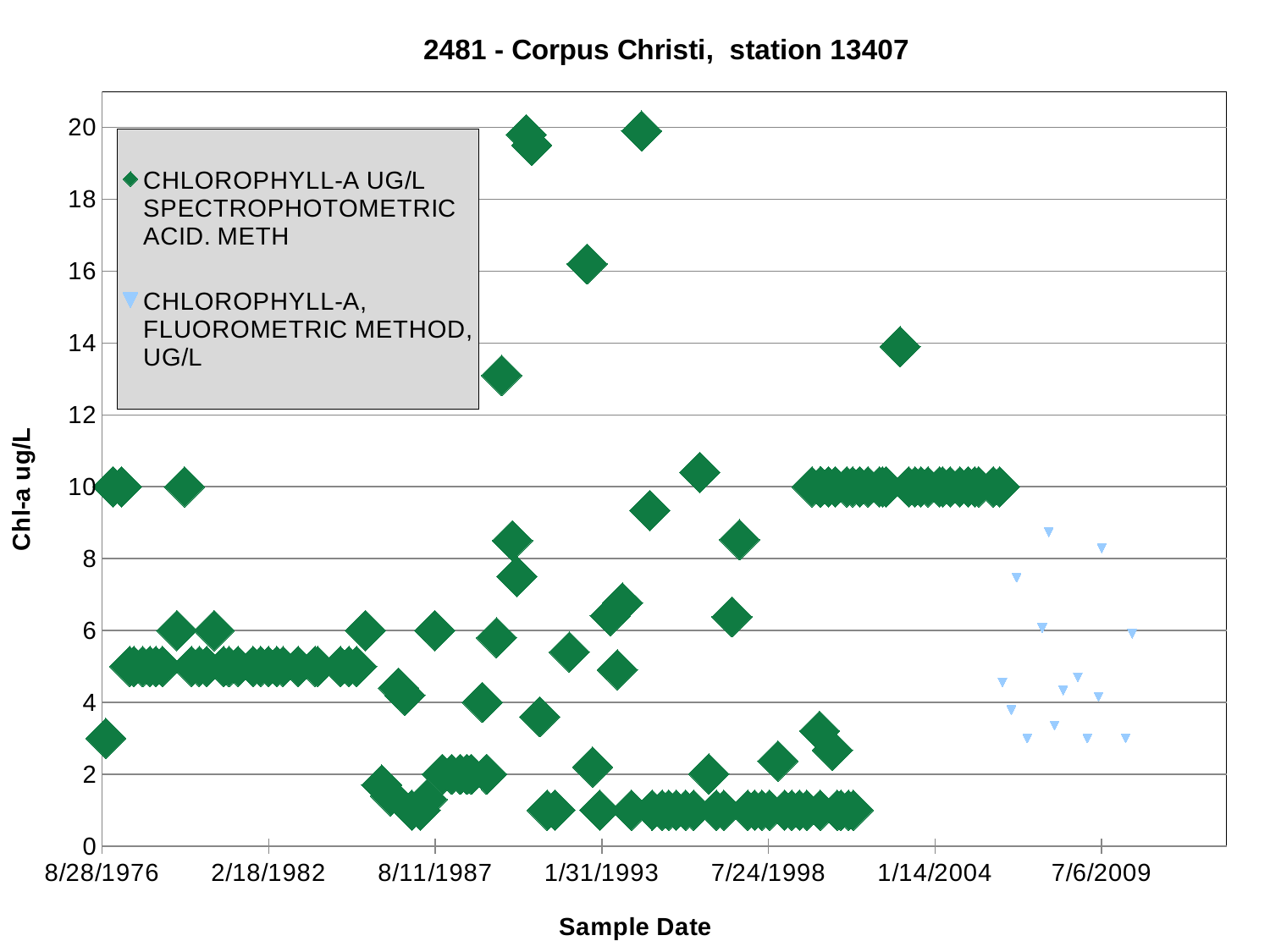
How many series does the legend list? 2 Is the lowest value plotted for the CHLOROPHYLL-A UG/L SPECTROPHOTOMETRIC ACID. METH series greater or less than 2? less Is the value plotted for the spectrophotometric series near 1/14/2004 that stands above the cluster at 10 greater or less than 12? greater What kind of chart is shown on the slide? scatter chart Is the lowest value plotted for the CHLOROPHYLL-A, FLUOROMETRIC METHOD, UG/L series greater or less than 2? greater What is the label of the y axis? Chl-a ug/L Are the values for the CHLOROPHYLL-A, FLUOROMETRIC METHOD, UG/L series plotted before or after the values for the spectrophotometric series along the x axis? after What is the title of the chart? 2481 - Corpus Christi, station 13407 Which series reaches the higher maximum value, the spectrophotometric series or the fluorometric series? CHLOROPHYLL-A UG/L SPECTROPHOTOMETRIC ACID. METH